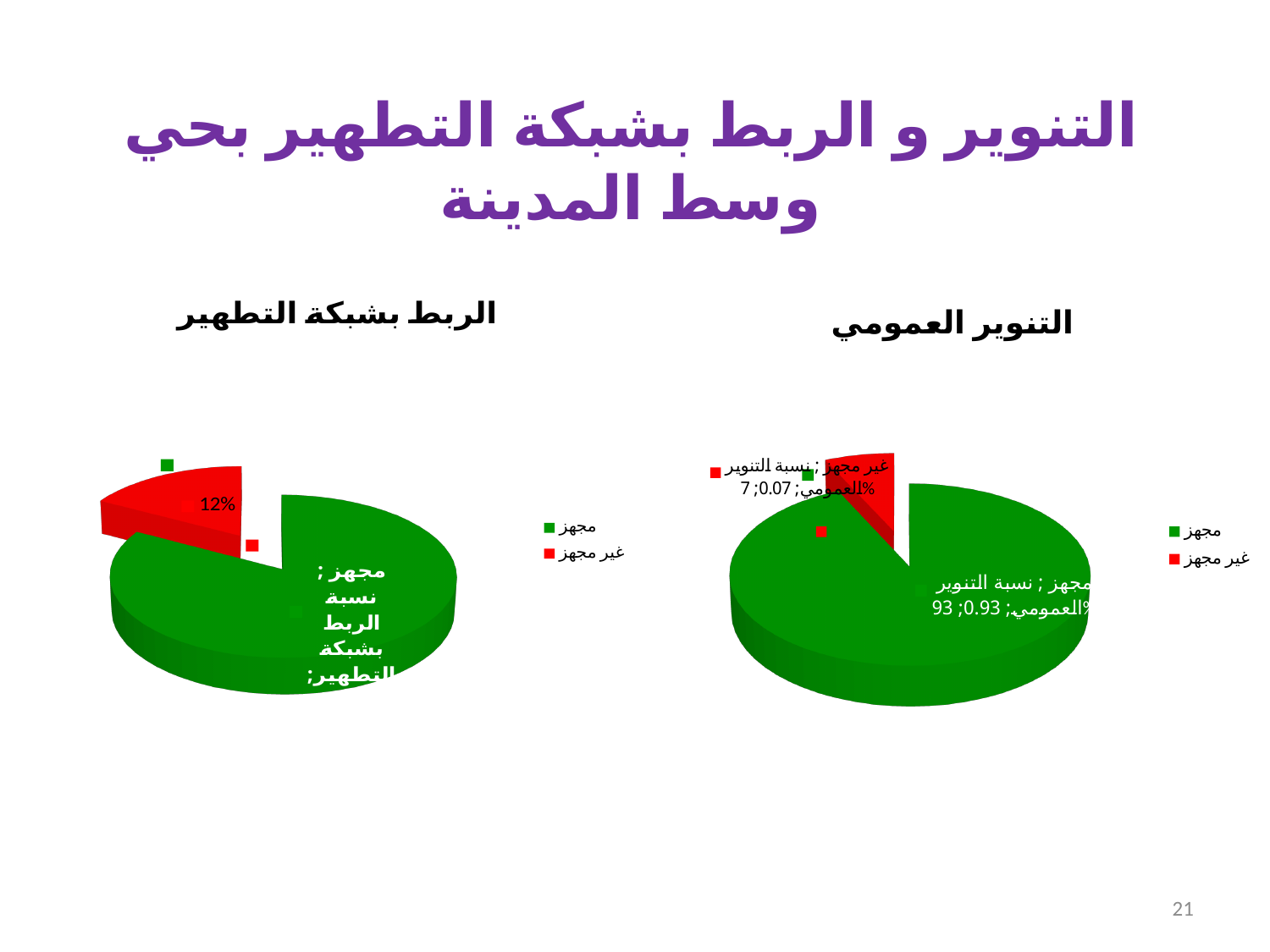
In the chart titled التنوير العمومي, what is the difference in percentage points between the مجهز and غير مجهز slices? 86 In the chart titled التنوير العمومي, what percentage is shown for the مجهز slice? 93% In the chart titled الربط بشبكة التطهير, what percentage is shown for the غير مجهز slice? 12% How many entries does the legend of the chart titled الربط بشبكة التطهير list? 2 In the chart titled التنوير العمومي, which category has the smallest slice? غير مجهز In the chart titled التنوير العمومي, what colour is the مجهز slice? green What type of chart is the chart titled الربط بشبكة التطهير? pie chart How many slices does the chart titled التنوير العمومي have? 2 In the chart titled التنوير العمومي, which category has the largest slice? مجهز In the chart titled الربط بشبكة التطهير, which slice is larger, مجهز or غير مجهز? مجهز In the chart titled التنوير العمومي, what percentage is shown for the غير مجهز slice? 7% In the chart titled الربط بشبكة التطهير, what colour is the غير مجهز slice? red